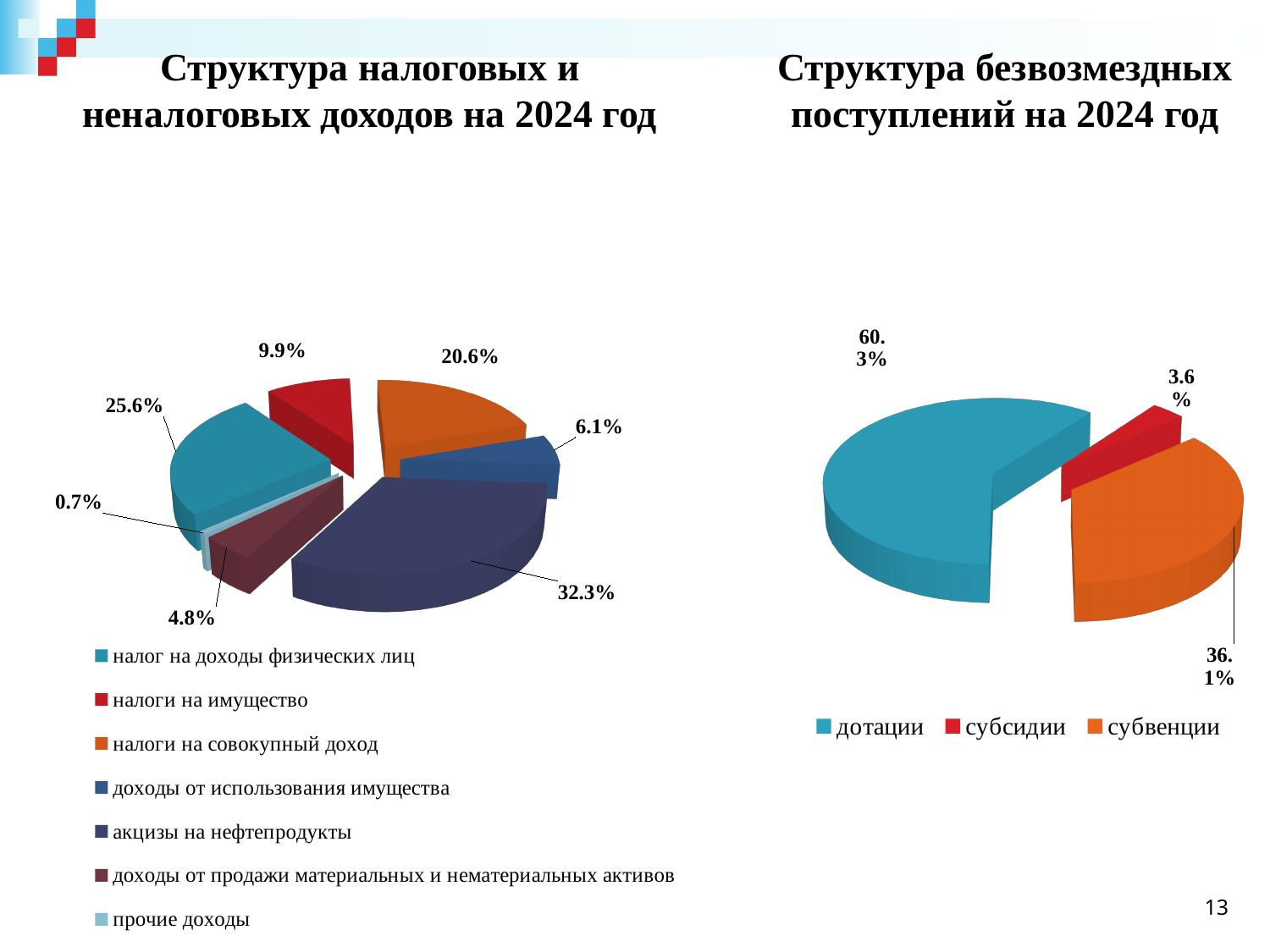
What type of chart is 'Структура безвозмездных поступлений на 2024 год'? pie chart On the chart 'Структура безвозмездных поступлений на 2024 год', which category has the largest share? дотации On the chart 'Структура налоговых и неналоговых доходов на 2024 год', which category has the smallest share? прочие доходы On the chart 'Структура безвозмездных поступлений на 2024 год', how many categories does the legend list? 3 On the chart 'Структура налоговых и неналоговых доходов на 2024 год', what is the difference between the shares of 'налоги на совокупный доход' and 'налоги на имущество'? 10.7% On the chart 'Структура налоговых и неналоговых доходов на 2024 год', how many categories does the legend list? 7 On the chart 'Структура налоговых и неналоговых доходов на 2024 год', what share is shown for 'налог на доходы физических лиц'? 25.6% On the chart 'Структура налоговых и неналоговых доходов на 2024 год', what share is shown for 'акцизы на нефтепродукты'? 32.3% On the chart 'Структура безвозмездных поступлений на 2024 год', what is the difference between the shares of 'дотации' and 'субвенции'? 24.2% On the chart 'Структура безвозмездных поступлений на 2024 год', what share is shown for 'субвенции'? 36.1% On the chart 'Структура налоговых и неналоговых доходов на 2024 год', which category has the largest share? акцизы на нефтепродукты On the chart 'Структура налоговых и неналоговых доходов на 2024 год', which is larger: 'доходы от использования имущества' or 'доходы от продажи материальных и нематериальных активов'? доходы от использования имущества